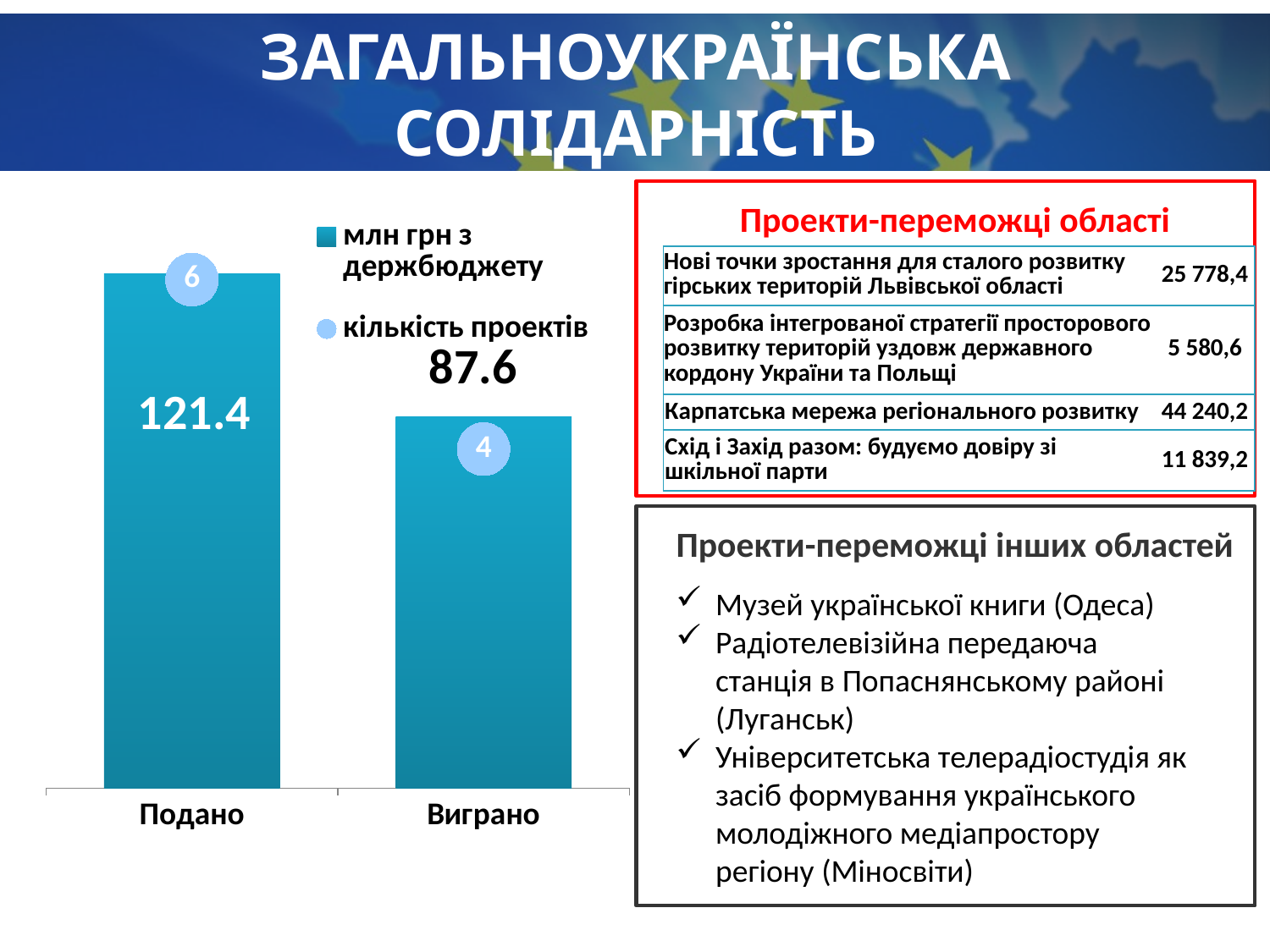
What is the value of "млн грн з держбюджету" for "Виграно"? 87.6 What is the value of "млн грн з держбюджету" for "Подано"? 121.4 What kind of chart is shown on the slide? bar chart Which category has the higher "млн грн з держбюджету" value? Подано Is the "млн грн з держбюджету" value for "Подано" larger or smaller than that for "Виграно"? larger How many categories are shown on the x axis of the chart? 2 How many more projects were submitted ("Подано") than won ("Виграно") according to "кількість проектів"? 2 What is the difference in "млн грн з держбюджету" between "Подано" and "Виграно"? 33.8 Which category has the lower "кількість проектів" value? Виграно What is the "кількість проектів" value for "Виграно"? 4 How many series does the chart legend list? 2 What is the "кількість проектів" value for "Подано"? 6